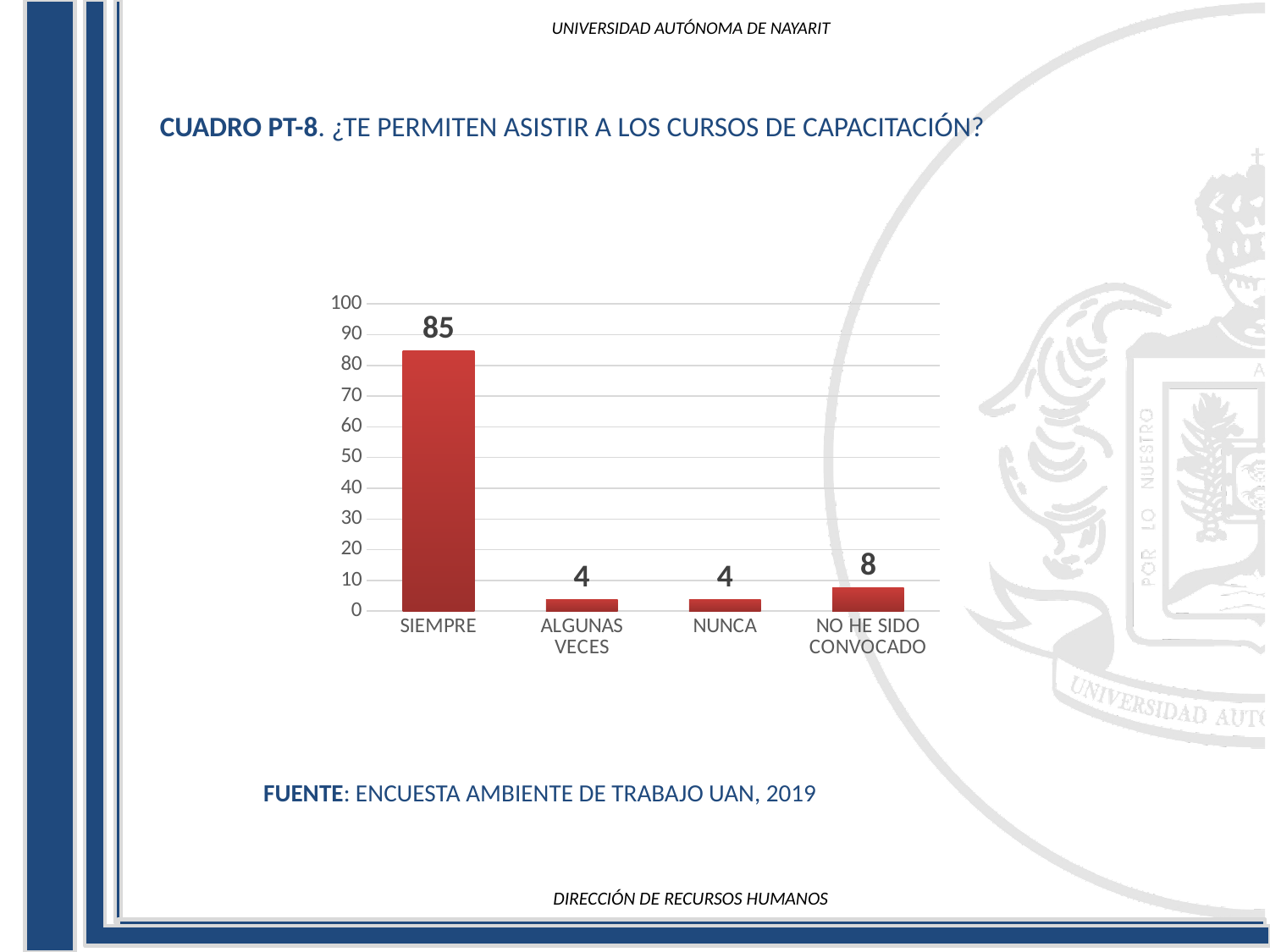
How many categories are shown on the x axis? 4 What kind of chart is shown on the slide? bar chart What is the source cited below the chart? ENCUESTA AMBIENTE DE TRABAJO UAN, 2019 What is the value for ALGUNAS VECES? 4 Which is larger, the value for NUNCA or the value for NO HE SIDO CONVOCADO? NO HE SIDO CONVOCADO Is the value for SIEMPRE greater or less than 80? greater What is the difference between the values for SIEMPRE and NO HE SIDO CONVOCADO? 77 What is the value for SIEMPRE? 85 What is the difference between the values for NO HE SIDO CONVOCADO and NUNCA? 4 Which category has the highest value? SIEMPRE What is the value for NO HE SIDO CONVOCADO? 8 Is the value for NO HE SIDO CONVOCADO greater or less than 10? less